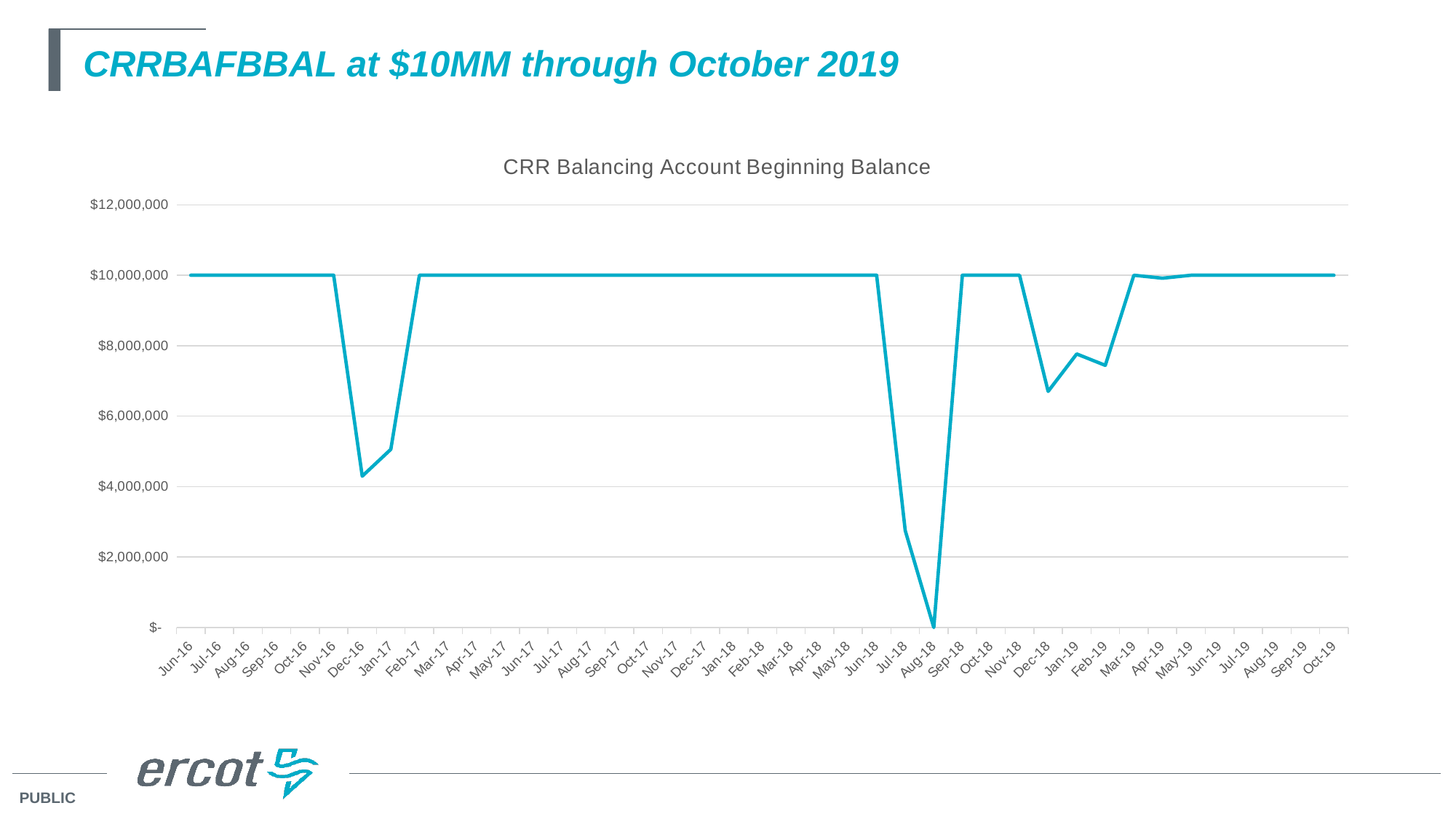
Does the CRR Balancing Account Beginning Balance rise or fall from Jun-18 to Aug-18? fall What is the CRR Balancing Account Beginning Balance for Oct-19? $10,000,000 Is the value for Dec-18 greater or less than $6,000,000? greater Is the value for Jan-19 greater or less than $8,000,000? less What kind of chart is shown on the slide? line chart What is the title of the chart? CRR Balancing Account Beginning Balance Is the value for Dec-16 greater or less than $6,000,000? less How many months are plotted on the x axis? 41 What is the CRR Balancing Account Beginning Balance for Jun-16? $10,000,000 Which month has the lowest CRR Balancing Account Beginning Balance? Aug-18 Which is larger, the value for Dec-16 or the value for Dec-18? Dec-18